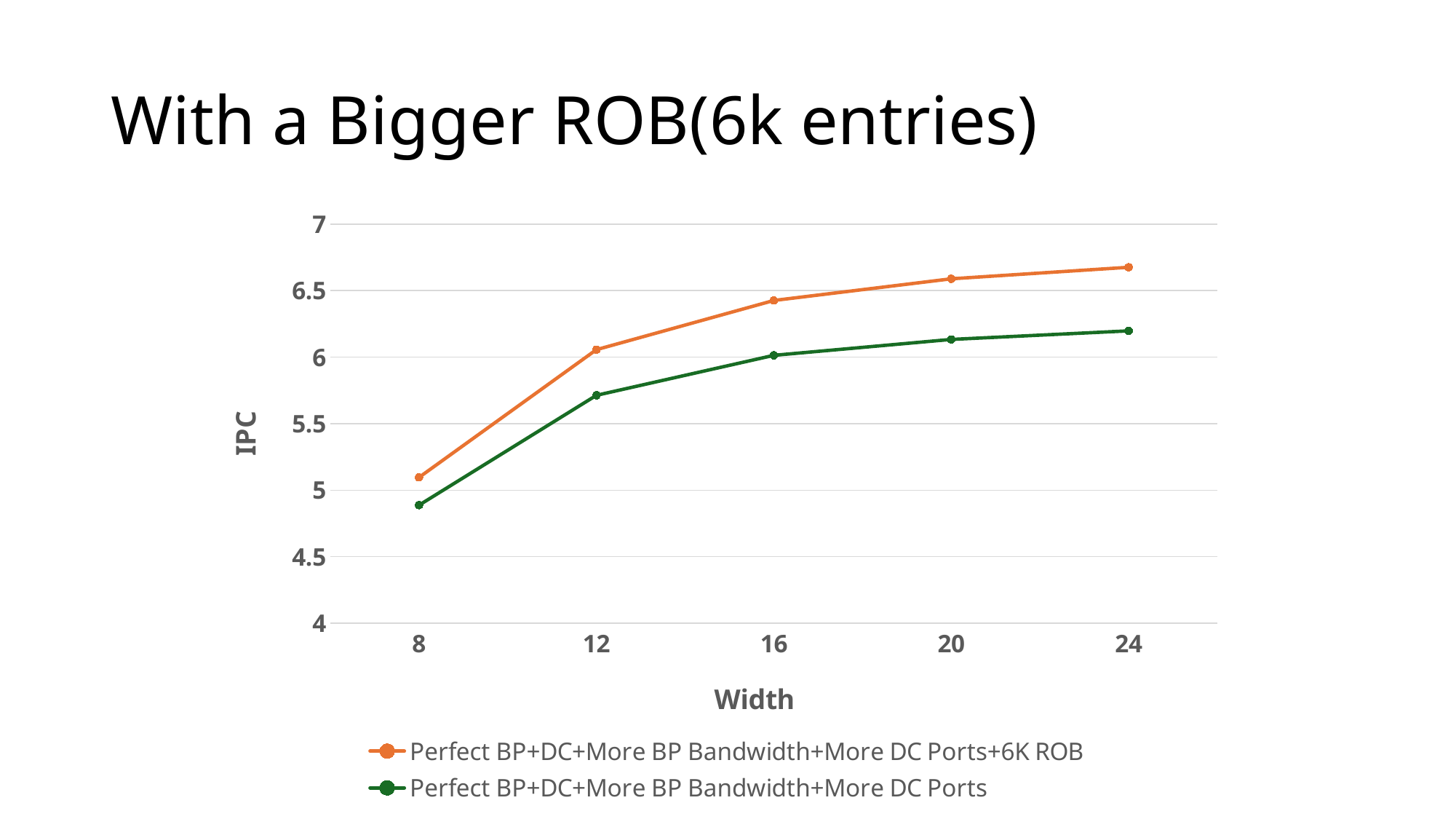
At which Width does the 'Perfect BP+DC+More BP Bandwidth+More DC Ports' series reach its highest IPC? 24 Is the IPC for the 'Perfect BP+DC+More BP Bandwidth+More DC Ports' series at Width 12 greater or less than 5.5? greater What kind of chart is shown on the slide? line chart Is the IPC for the 'Perfect BP+DC+More BP Bandwidth+More DC Ports' series at Width 8 greater or less than 5? less How many width values are plotted along the x axis? 5 Is the IPC for the 'Perfect BP+DC+More BP Bandwidth+More DC Ports+6K ROB' series at Width 24 greater or less than 6.5? greater Do the IPC values for the 'Perfect BP+DC+More BP Bandwidth+More DC Ports+6K ROB' series rise or fall as Width increases? rise At Width 16, which series has the higher IPC? Perfect BP+DC+More BP Bandwidth+More DC Ports+6K ROB How many series does the legend list? 2 Which colour is used for the 'Perfect BP+DC+More BP Bandwidth+More DC Ports+6K ROB' series? orange At which Width does the 'Perfect BP+DC+More BP Bandwidth+More DC Ports+6K ROB' series have its lowest IPC? 8 What is the label of the y axis? IPC